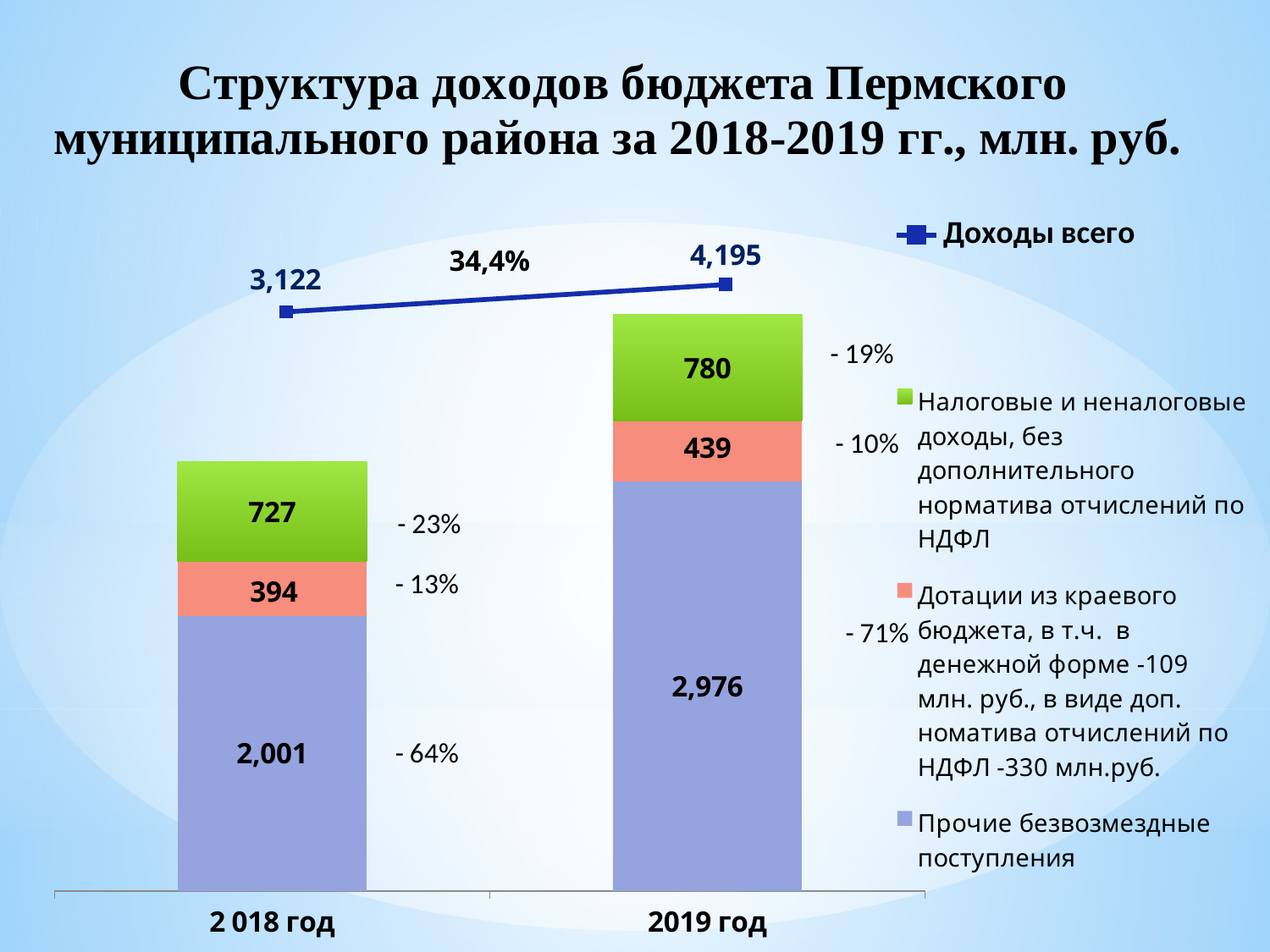
What is the difference between Дотации из краевого бюджета in 2019 год and 2018 год? 45 What is the value of Налоговые и неналоговые доходы for 2019 год? 780 What percentage growth is labelled on the Доходы всего line between 2018 and 2019? 34,4% Does Доходы всего rise or fall from 2018 год to 2019 год? Rise What is the value of Доходы всего for 2019 год? 4,195 What is the total of the stacked bar for 2018 год? 3,122 How many categories are shown on the x axis? 2 What is the value of Прочие безвозмездные поступления for 2018 год? 2,001 Which year has the higher value for Налоговые и неналоговые доходы, 2018 год or 2019 год? 2019 год What is the value of Прочие безвозмездные поступления for 2019 год? 2,976 What is the value of Дотации из краевого бюджета for 2018 год? 394 What kind of chart is shown on the slide? Stacked bar chart with a line